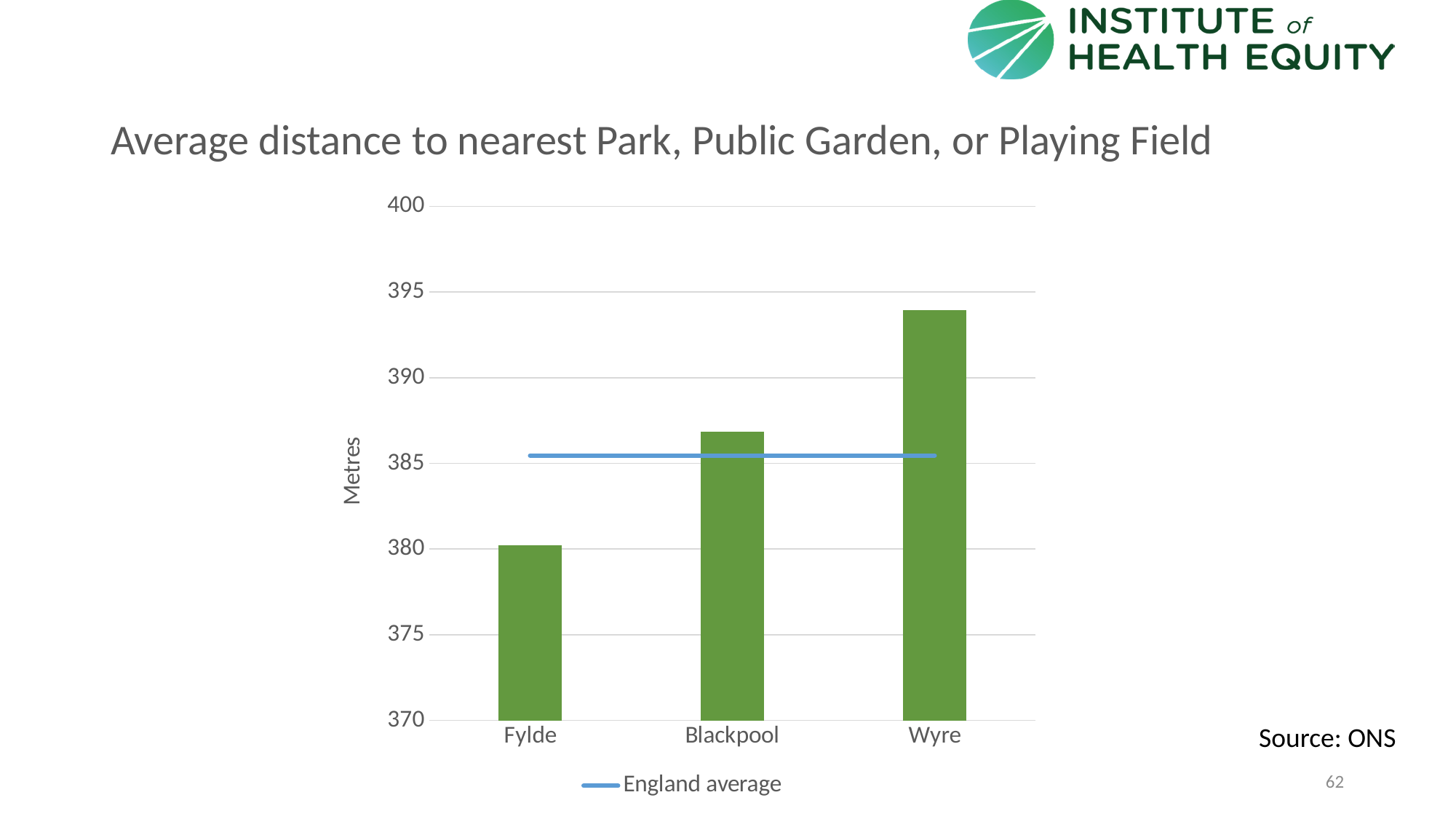
Is the value for Wyre greater or less than 390? greater Is the value for Fylde greater or less than 385? less Which area has the greatest average distance to the nearest park, public garden, or playing field? Wyre Which area has the smallest average distance to the nearest park, public garden, or playing field? Fylde Do the bar values rise or fall moving from Fylde to Wyre along the x axis? rise Is the value for Blackpool greater or less than 390? less How many areas (bars) are plotted on the chart? 3 What kind of chart is shown on the slide? bar chart Which has the larger average distance, Blackpool or Fylde? Blackpool How many entries does the chart legend list? 1 What is the label on the vertical axis of the chart? Metres What does the horizontal blue line on the chart represent? England average